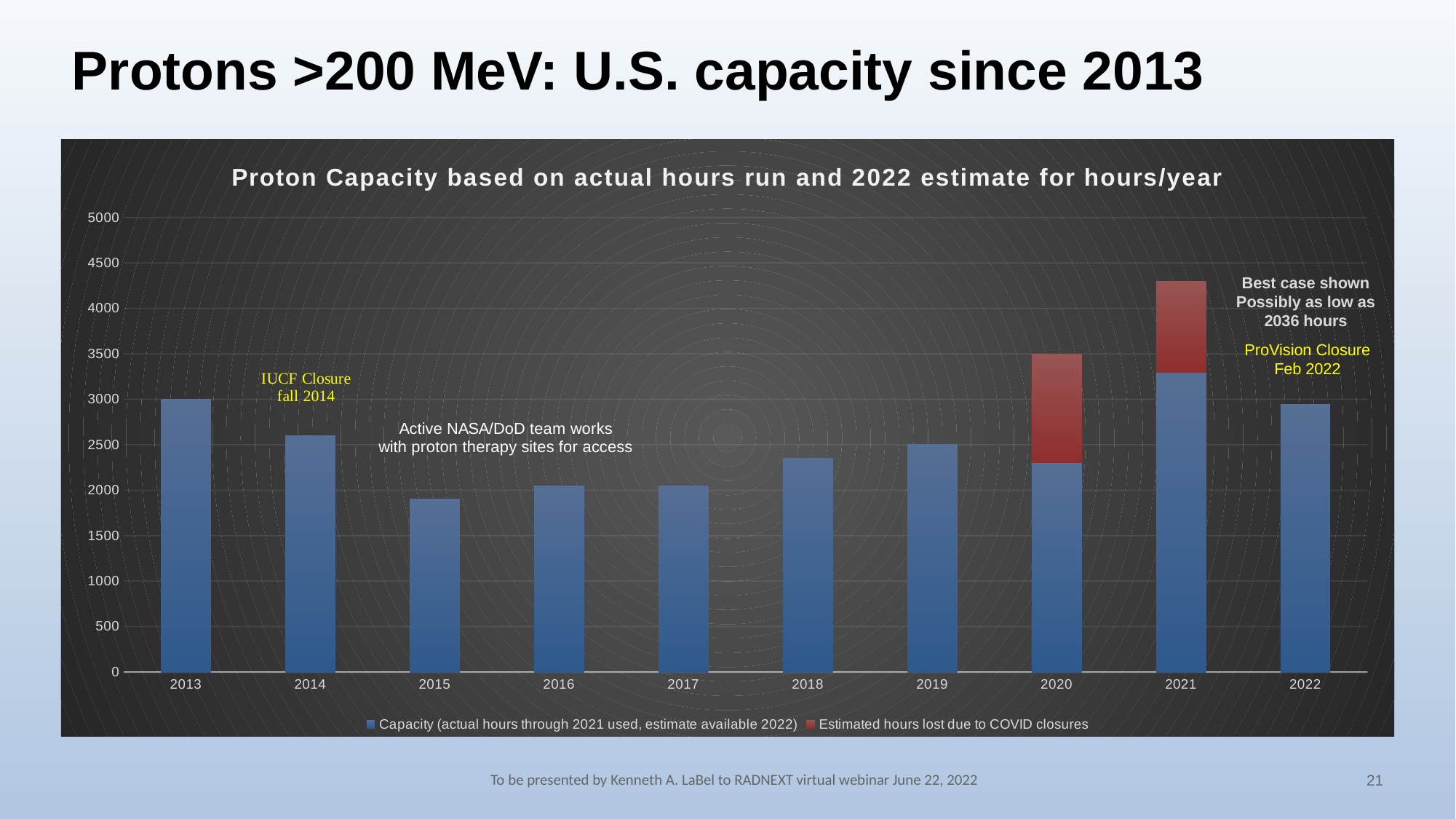
How many series does the chart legend list? 2 Which year has the lowest capacity bar? 2015 Is the capacity value for 2018 greater or less than 2000? greater Do the capacity bars rise or fall from 2015 to 2019? rise Is the capacity value for 2014 greater or less than 2500? greater Which year has the highest blue capacity bar? 2021 What is the capacity value for 2013? 3000 Is the blue capacity value for 2021 greater or less than 3000? greater What does the red series in the legend represent? Estimated hours lost due to COVID closures What kind of chart is shown on the slide? bar chart Which year has the larger capacity bar, 2013 or 2014? 2013 How many years are shown along the x axis of the chart? 10